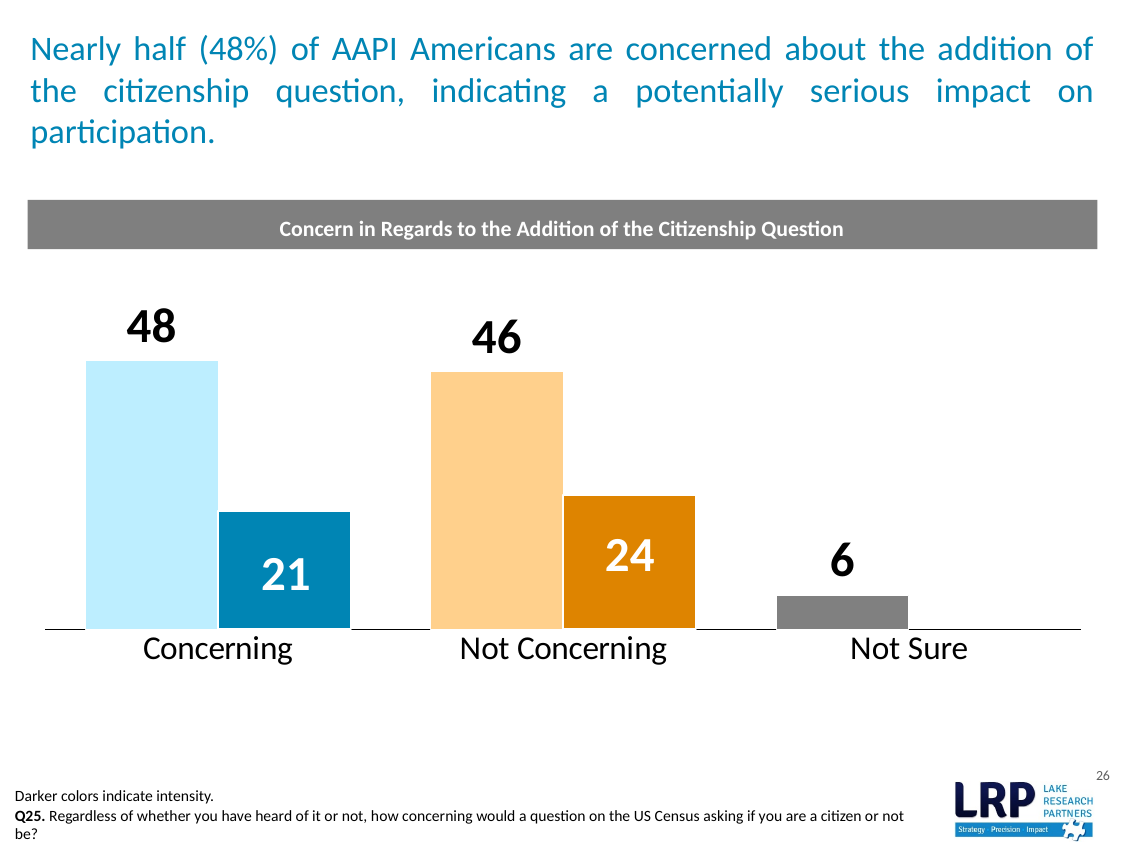
What is the value of the darker bar for Not Concerning? 24 Which is larger: the darker bar for Concerning or the darker bar for Not Concerning? Not Concerning What is the value of the darker bar for Concerning? 21 Which category has the lowest value? Not Sure What is the difference between the darker bar for Not Concerning and the darker bar for Concerning? 3 What is the value of the lighter bar for Concerning? 48 What is the title of the chart? Concern in Regards to the Addition of the Citizenship Question Which category has the highest value among the lighter bars? Concerning What kind of chart is shown on the slide? Bar chart What is the difference between the lighter bar for Concerning and the lighter bar for Not Concerning? 2 What is the value for Not Sure? 6 How many categories are shown on the x axis? 3